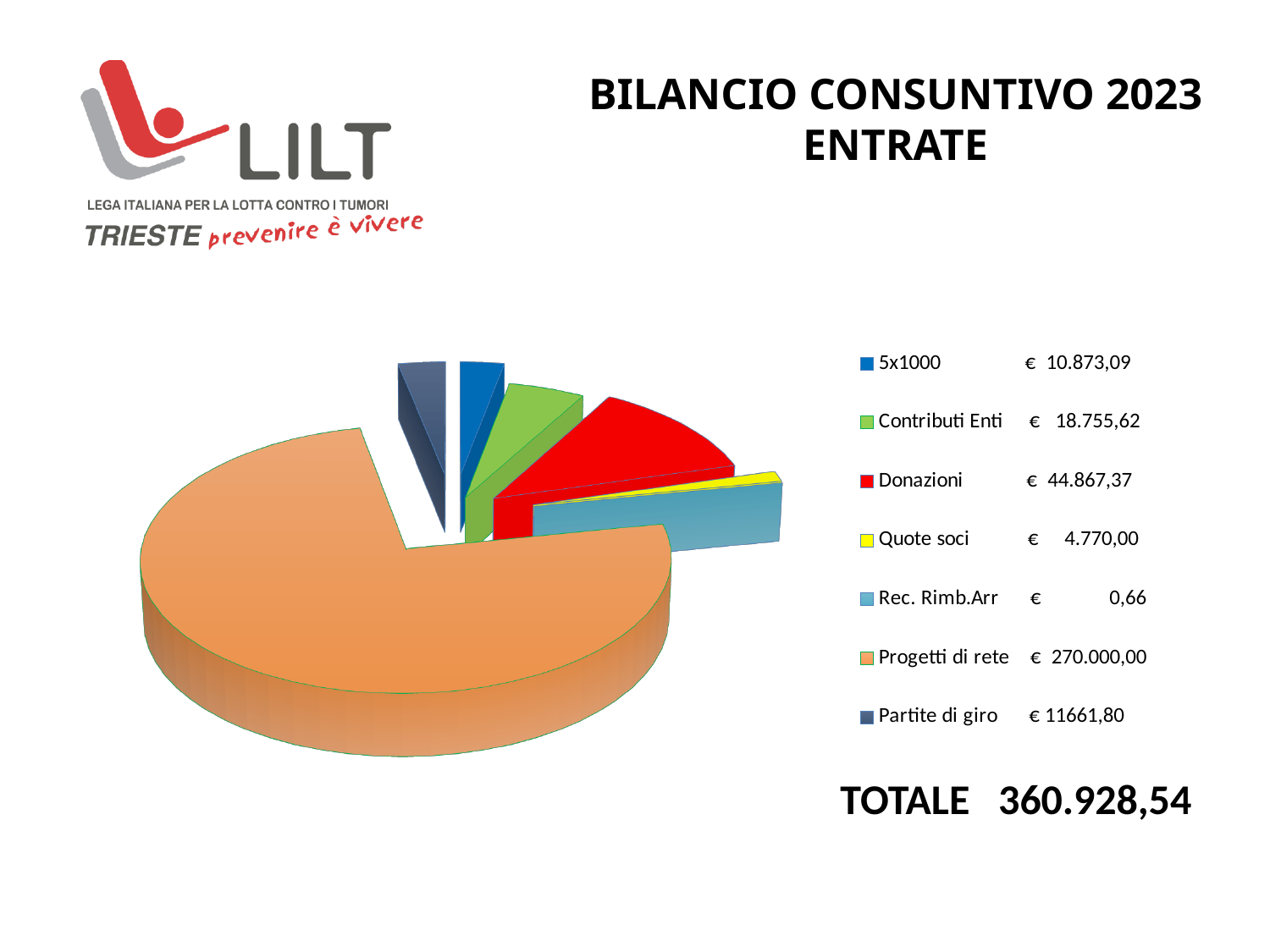
Which is larger, Partite di giro or 5x1000? Partite di giro What is the difference between Donazioni and Contributi Enti? 26.111,75 Which category has the smallest value? Rec. Rimb.Arr What is the value shown for Quote soci? € 4.770,00 What kind of chart is shown on the slide? Pie chart Which category has the largest value? Progetti di rete What is the value shown for Progetti di rete? € 270.000,00 What is the value shown for Partite di giro? € 11661,80 How many categories does the chart show? 7 What is the value shown for Donazioni? € 44.867,37 What colour represents Donazioni in the chart? Red What is the total (TOTALE) shown on the slide? 360.928,54